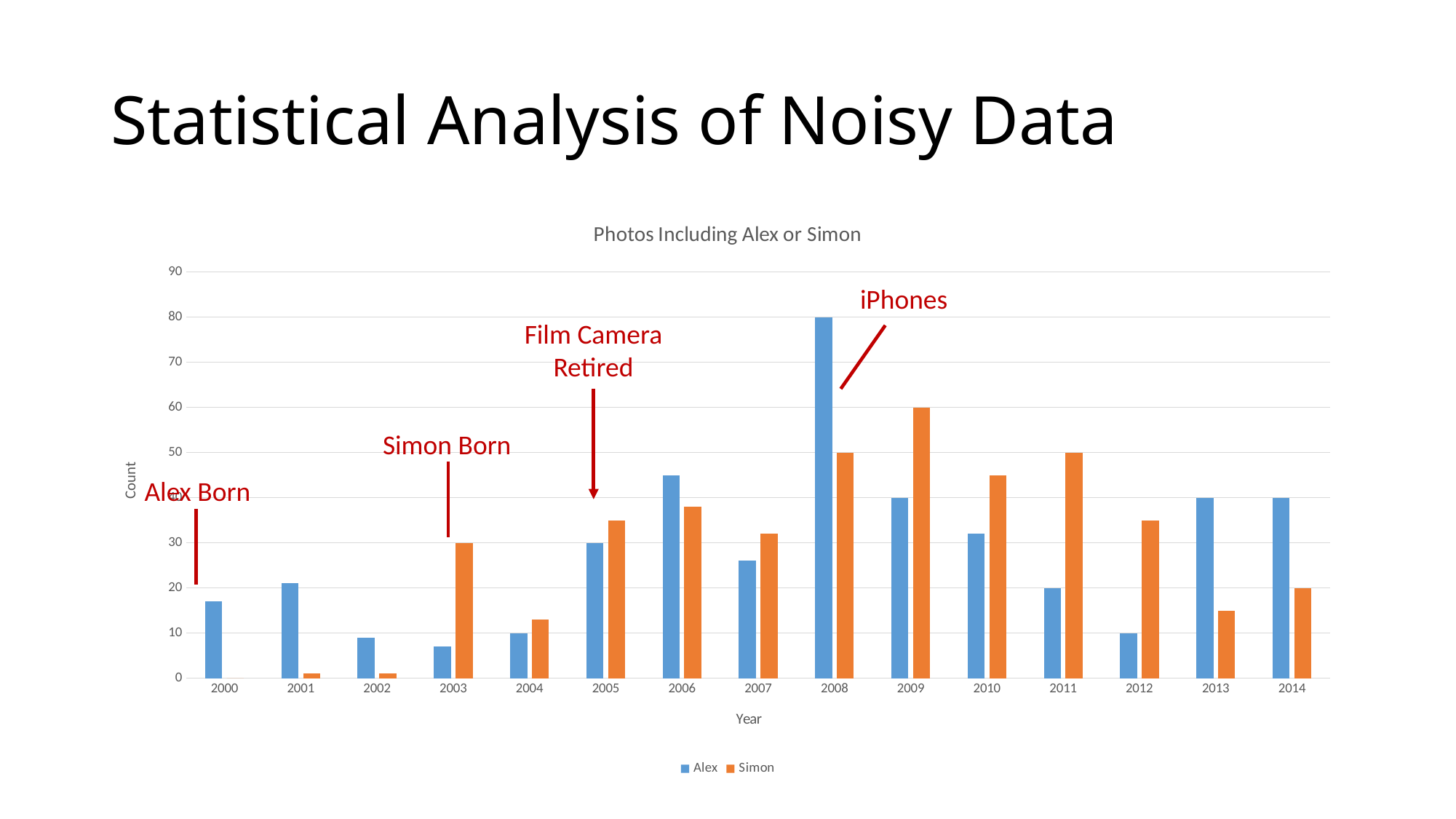
How many series does the legend list? 2 What type of chart is shown on the slide? Bar chart What is the value for Alex in 2008? 80 Is the value for Alex in 2000 greater or less than 20? less In 2011, which series has the larger value, Alex or Simon? Simon How many years are shown on the x axis? 15 Which year does the 'Film Camera Retired' annotation point to? 2005 What is the value for Simon in 2009? 60 Is the value for Alex in 2006 greater or less than 40? greater In which year is the Simon series highest? 2009 What is the title of the chart? Photos Including Alex or Simon In which year is the Alex series highest? 2008